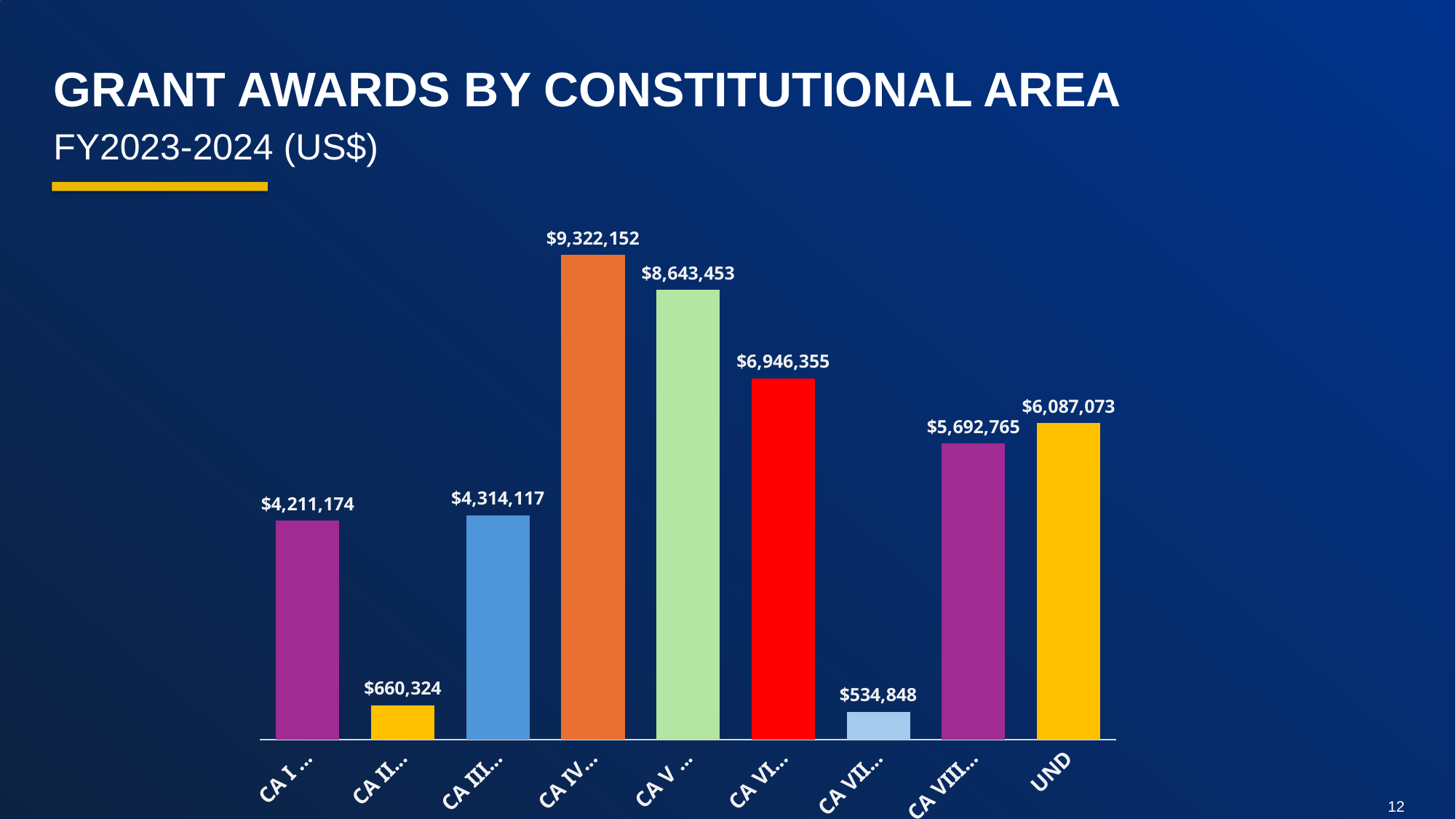
What is the grant award value for CA VII? $534,848 What fiscal year does the chart cover, according to the subtitle? FY2023-2024 What type of chart is shown on the slide? Bar chart Which is larger, the grant award for CA VI or for UND? CA VI What is the difference between the grant awards for CA IV and CA V? $678,699 How many categories are shown on the x axis of the chart? 9 Which category has the lowest grant award? CA VII Which constitutional area received the highest grant award? CA IV What is the grant award value for UND? $6,087,073 What is the difference between the grant awards for UND and CA VIII? $394,308 What is the grant award value for CA VIII? $5,692,765 What is the grant award value for CA IV? $9,322,152